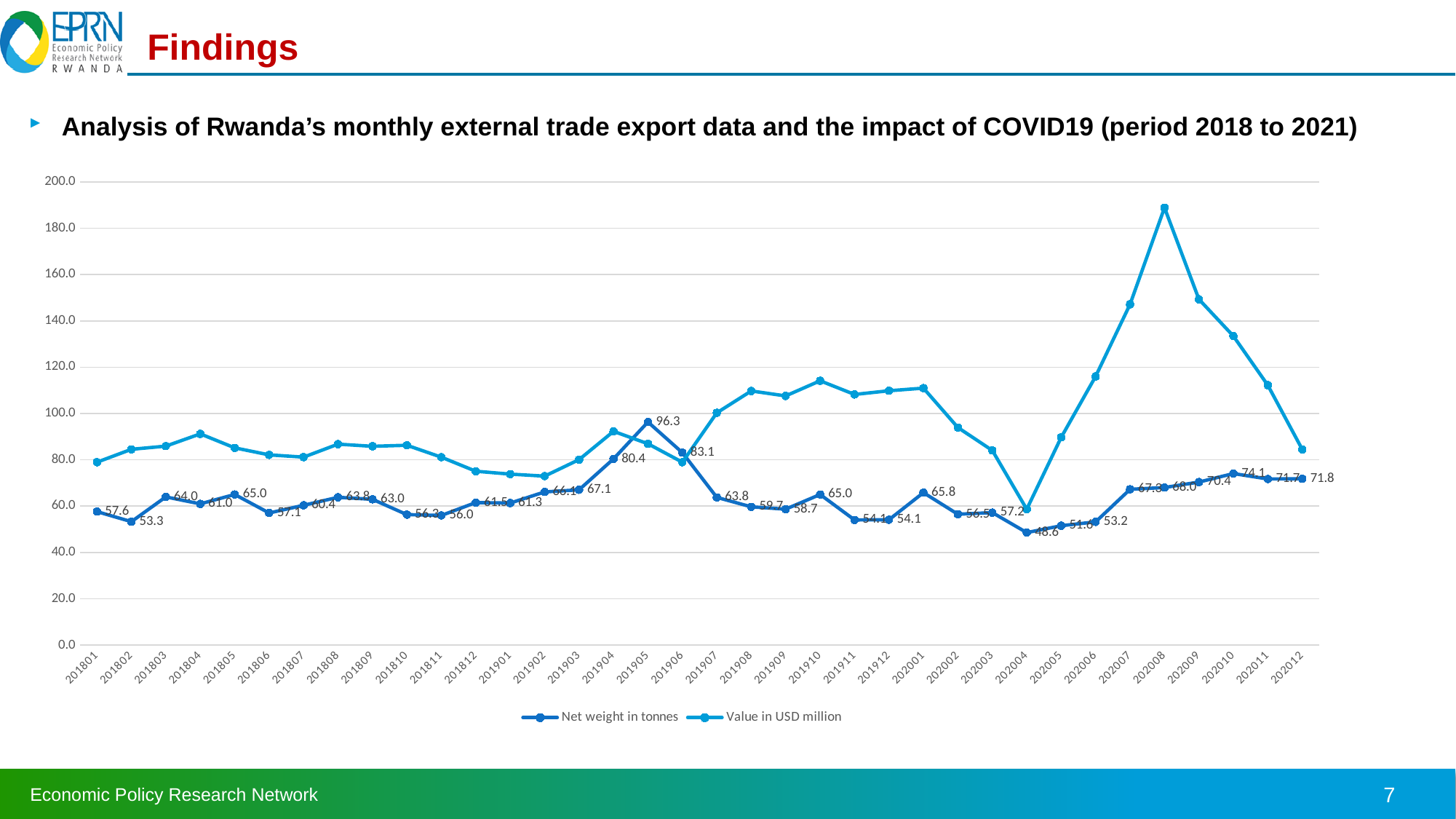
Is the Value in USD million for 202008 greater or less than 180? greater How many monthly points are plotted along the x axis? 36 In which month is the Net weight in tonnes highest? 201905 What kind of chart is shown on the slide? Line chart What is the Net weight in tonnes for 201905? 96.3 What is the difference between the Net weight in tonnes for 201905 and for 202004? 47.7 How many series does the legend list? 2 In which month is the Net weight in tonnes lowest? 202004 What is the Net weight in tonnes for 202004? 48.6 What is the Net weight in tonnes for 202012? 71.8 Which is larger, the Net weight in tonnes for 201904 or for 201907? 201904